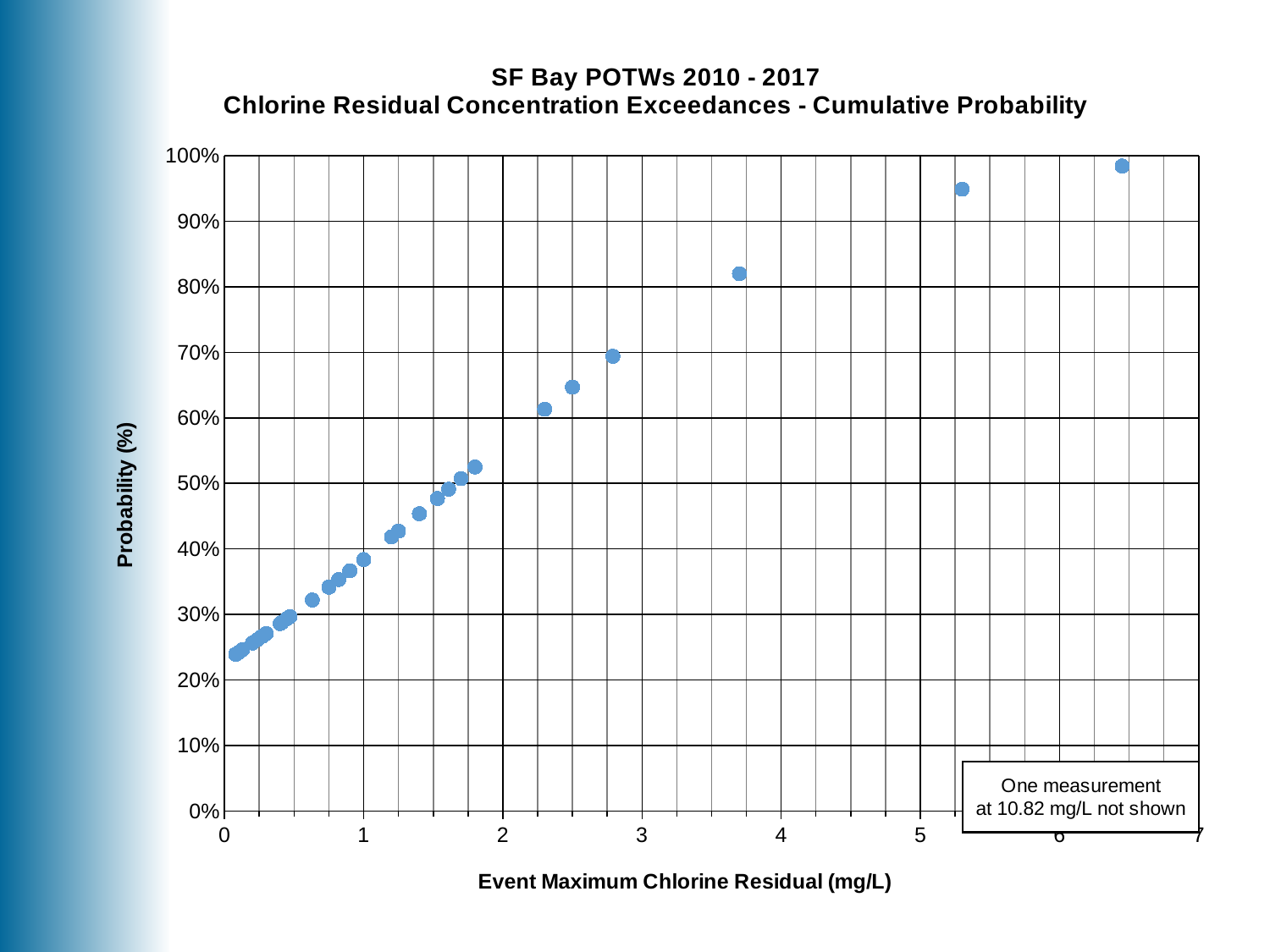
Is the probability for the point at about 2.3 mg/L greater or less than 60%? greater What is the label of the x axis? Event Maximum Chlorine Residual (mg/L) Do the plotted probability values rise or fall as the event maximum chlorine residual increases along the x axis? Rise Is the probability for the point at about 3.7 mg/L greater or less than 80%? greater What is the title of the chart? SF Bay POTWs 2010 - 2017 Chlorine Residual Concentration Exceedances - Cumulative Probability What kind of chart is shown on the slide? Scatter plot Is the probability for the point at about 5.3 mg/L greater or less than 90%? greater What is the highest value shown on the x axis? 7 Which plotted point has the highest probability: the one at about 6.5 mg/L or the one at about 3.7 mg/L? The one at about 6.5 mg/L